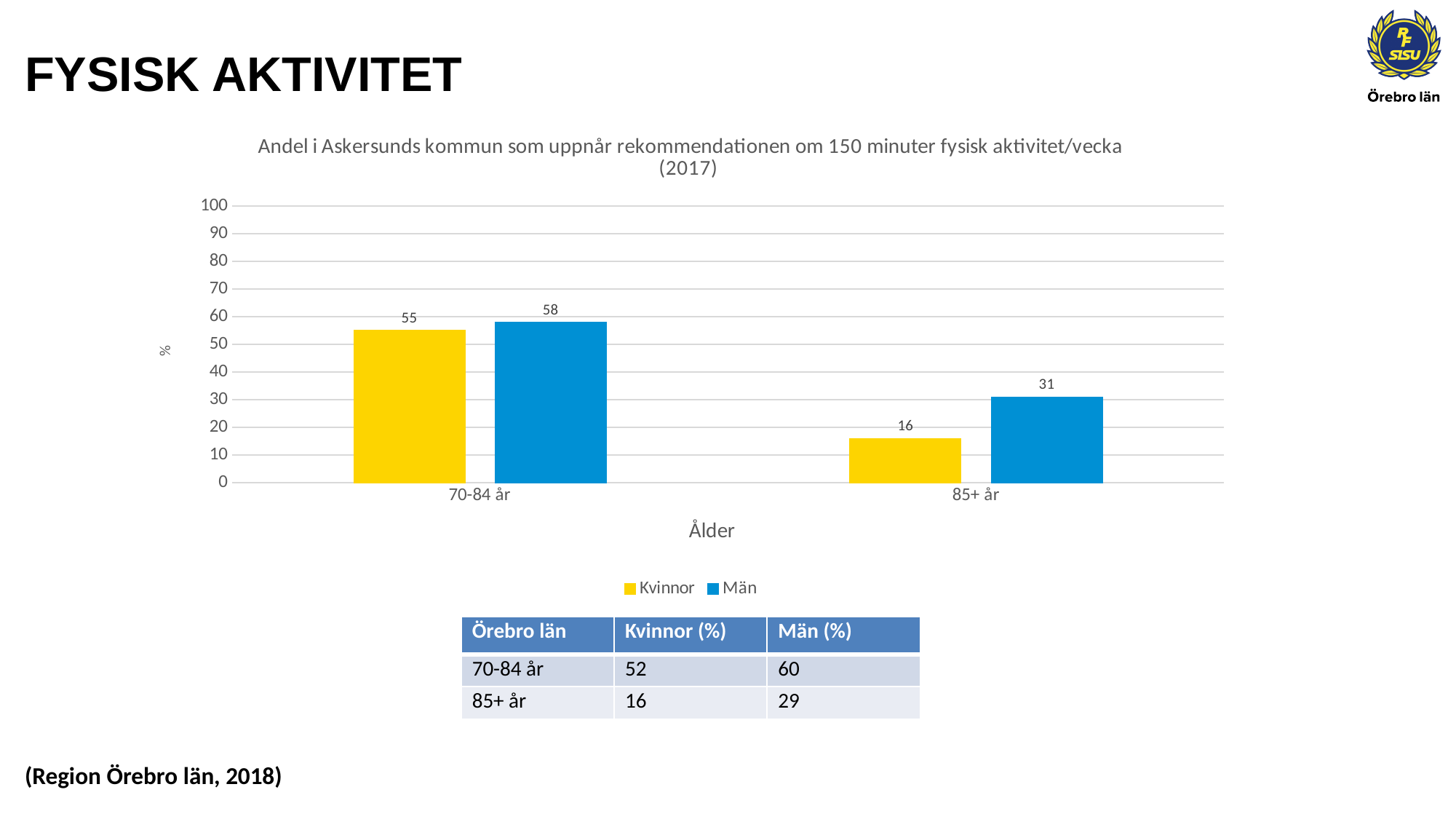
What is the difference between Män and Kvinnor in the 85+ år age group? 15 What is the value for Kvinnor in the 70-84 år age group? 55 Which series has the highest value in the 70-84 år age group? Män Which bar has the lowest value on the chart? Kvinnor, 85+ år What is the difference between the Män values for 70-84 år and 85+ år? 27 How many age groups are shown on the x axis? 2 What kind of chart is shown on the slide? Bar chart What is the value for Män in the 85+ år age group? 31 What is the label of the x axis? Ålder How many series does the legend list? 2 What is the value for Kvinnor in the 85+ år age group? 16 Which is larger: Kvinnor for 70-84 år or Män for 85+ år? Kvinnor for 70-84 år